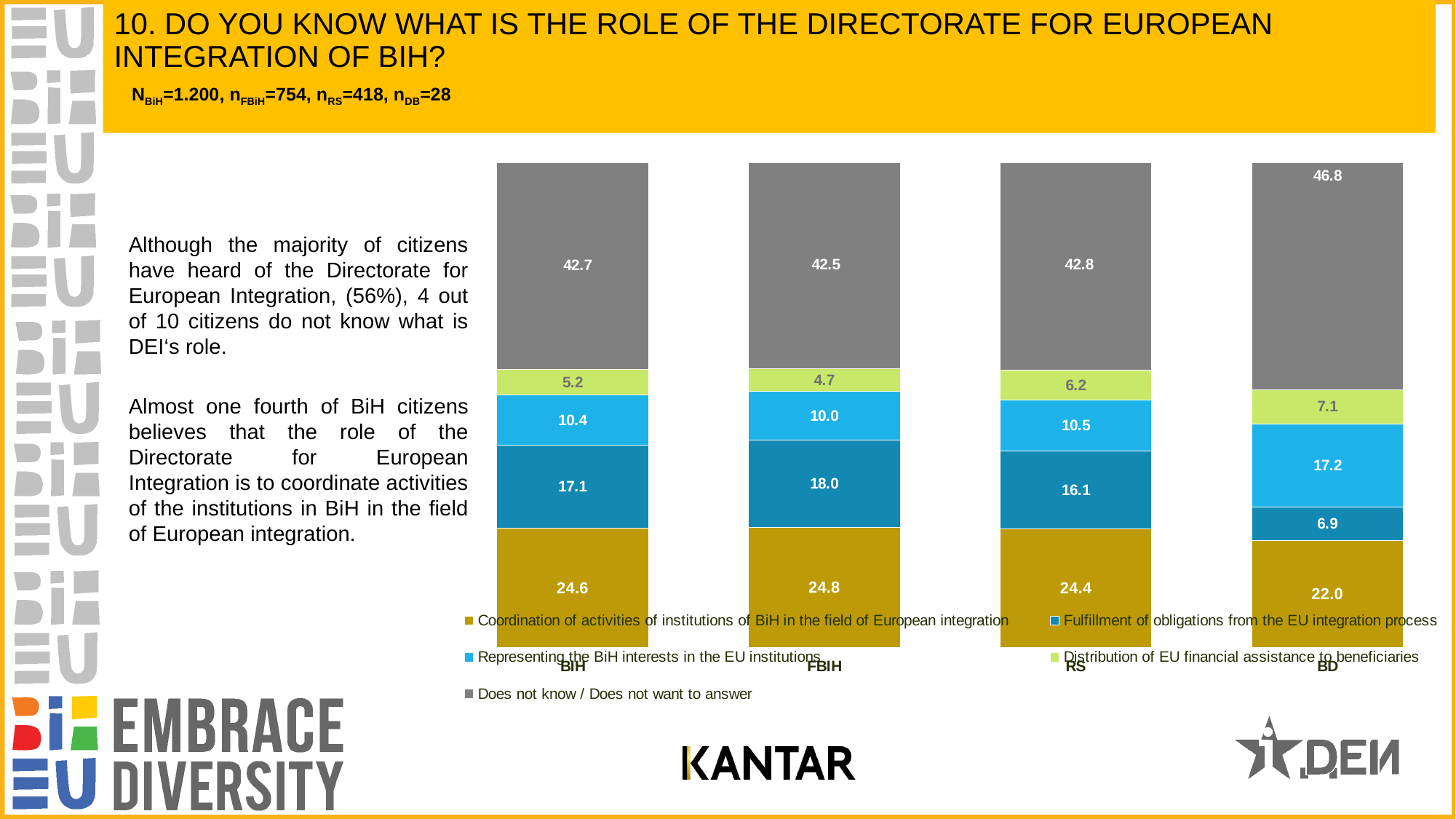
What is the value for 'Does not know / Does not want to answer' in the BD bar? 46.8 How many categories are shown on the x axis of the chart? 4 What is the total of the stacked bar for BiH? 100.0 Which colour represents 'Does not know / Does not want to answer' in the chart? grey Which is larger: the 'Distribution of EU financial assistance to beneficiaries' value for RS or for FBiH? RS Which category has the lowest value for 'Fulfillment of obligations from the EU integration process'? BD How many series does the chart's legend list? 5 Which category has the highest value for 'Representing the BiH interests in the EU institutions'? BD What type of chart is shown on the slide? stacked bar chart What is the value for 'Coordination of activities of institutions of BiH in the field of European integration' in the FBiH bar? 24.8 What is the difference between the 'Does not know / Does not want to answer' values for BD and BiH? 4.1 What is the value for 'Fulfillment of obligations from the EU integration process' in the RS bar? 16.1